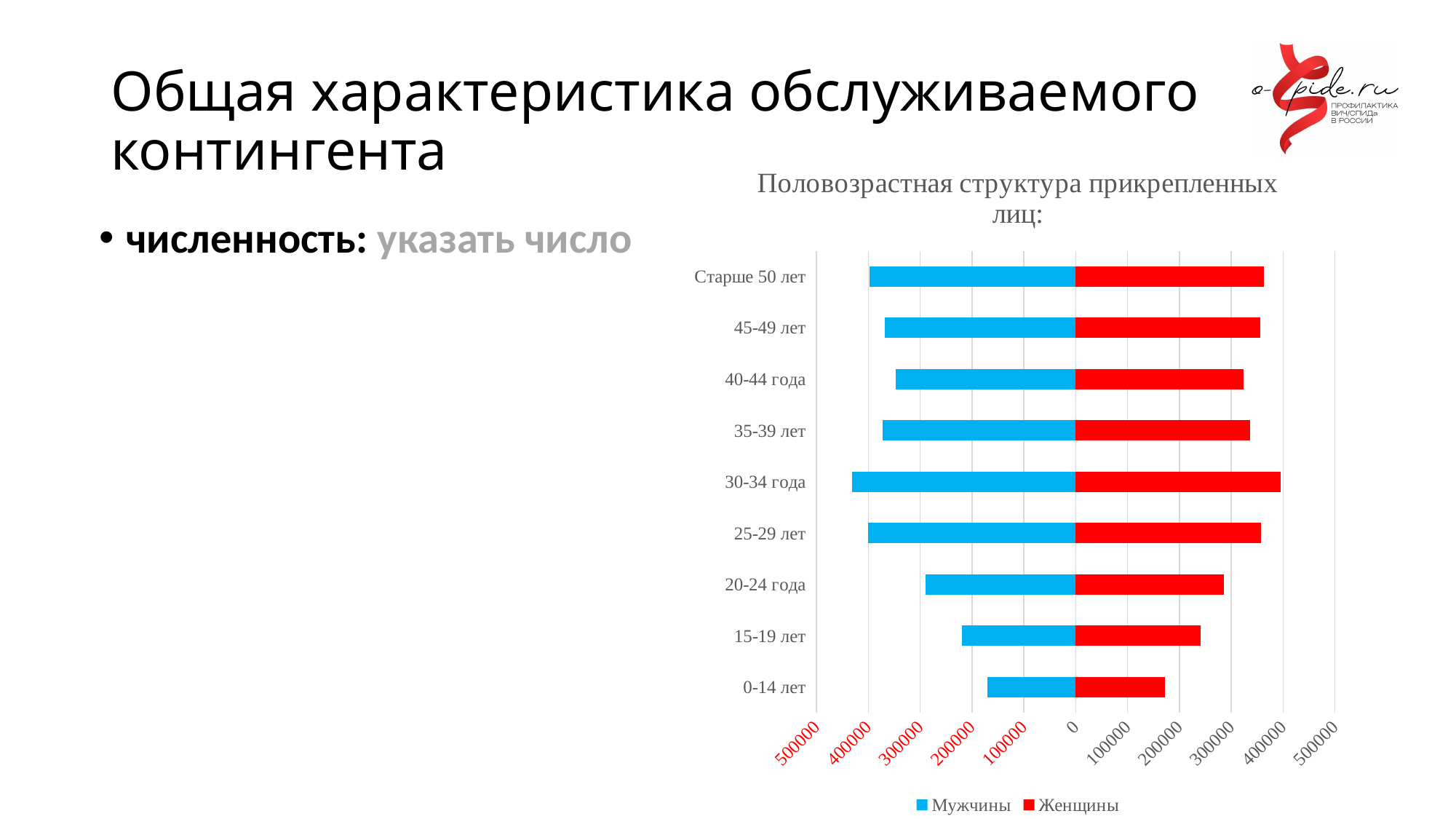
Which colour represents Женщины in the chart? red Which age group has the largest value for Женщины? 30-34 года Which age group has the smallest value for Женщины? 0-14 лет Which age group has the largest value for Мужчины? 30-34 года Is the value for Мужчины in the 30-34 года group greater or less than 400000? greater What is the title of the chart? Половозрастная структура прикрепленных лиц: How many series does the chart legend list? 2 Is the value for Женщины in the 40-44 года group greater or less than 300000? greater What kind of chart is shown on the slide? bar chart How many age groups are shown on the chart? 9 Which is larger: the value for Женщины in the 30-34 года group or in the 20-24 года group? 30-34 года Is the value for Мужчины in the 0-14 лет group greater or less than 200000? less